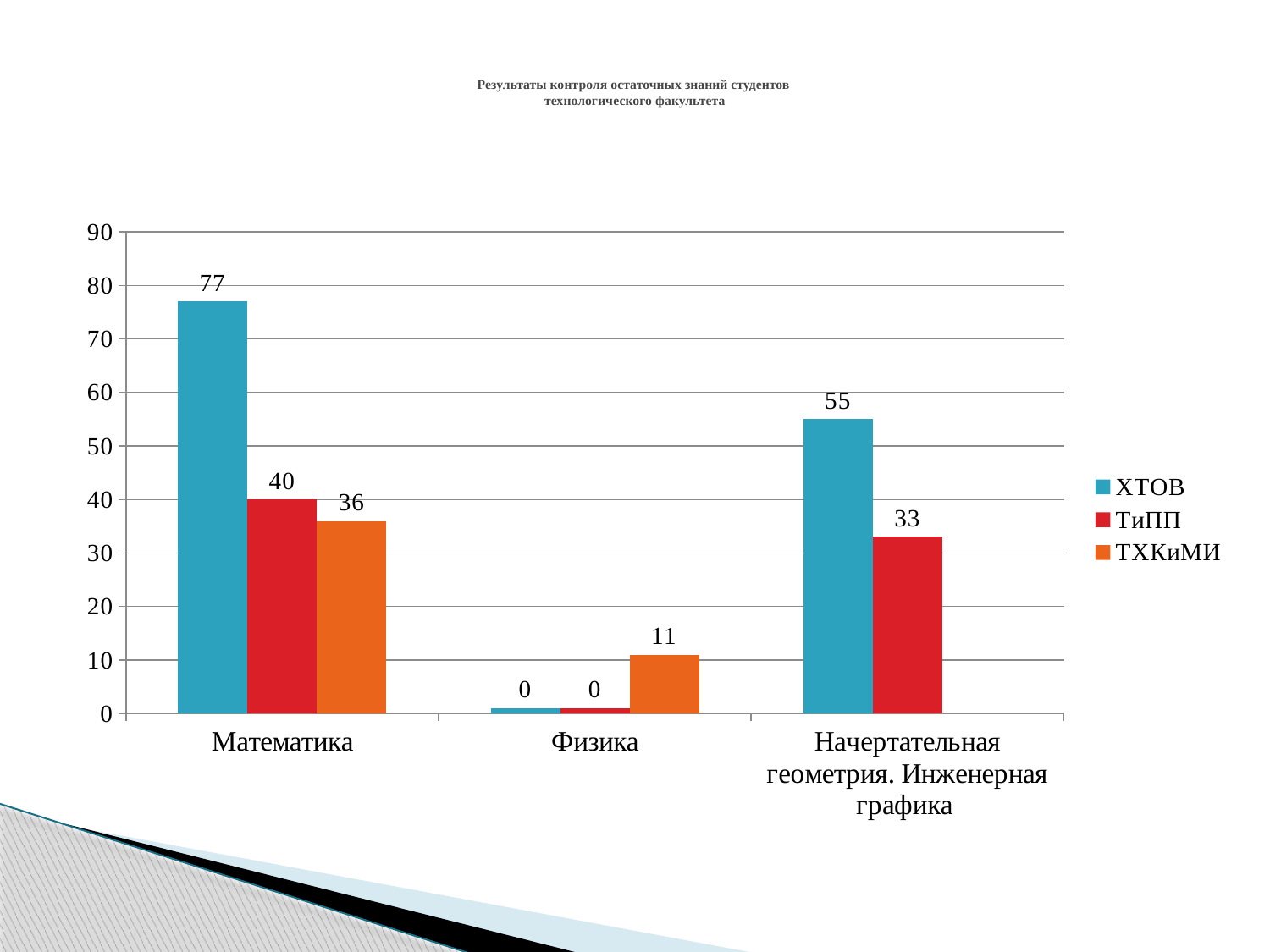
Which is larger in the Математика category: the value for ТиПП or the value for ТХКиМИ? ТиПП How many series does the legend list? 3 What is the difference between the ХТОВ and ТиПП values in the Математика category? 37 What kind of chart is shown on the slide? Bar chart What is the value for ТХКиМИ in the Физика category? 11 What is the value for ТиПП in the Начертательная геометрия. Инженерная графика category? 33 Which category has the highest value for ХТОВ? Математика Which category has the lowest value for ТиПП? Физика Which series is shown in red in the legend? ТиПП How many categories are shown on the x axis? 3 What is the value for ТиПП in the Математика category? 40 What is the value for ХТОВ in the Математика category? 77